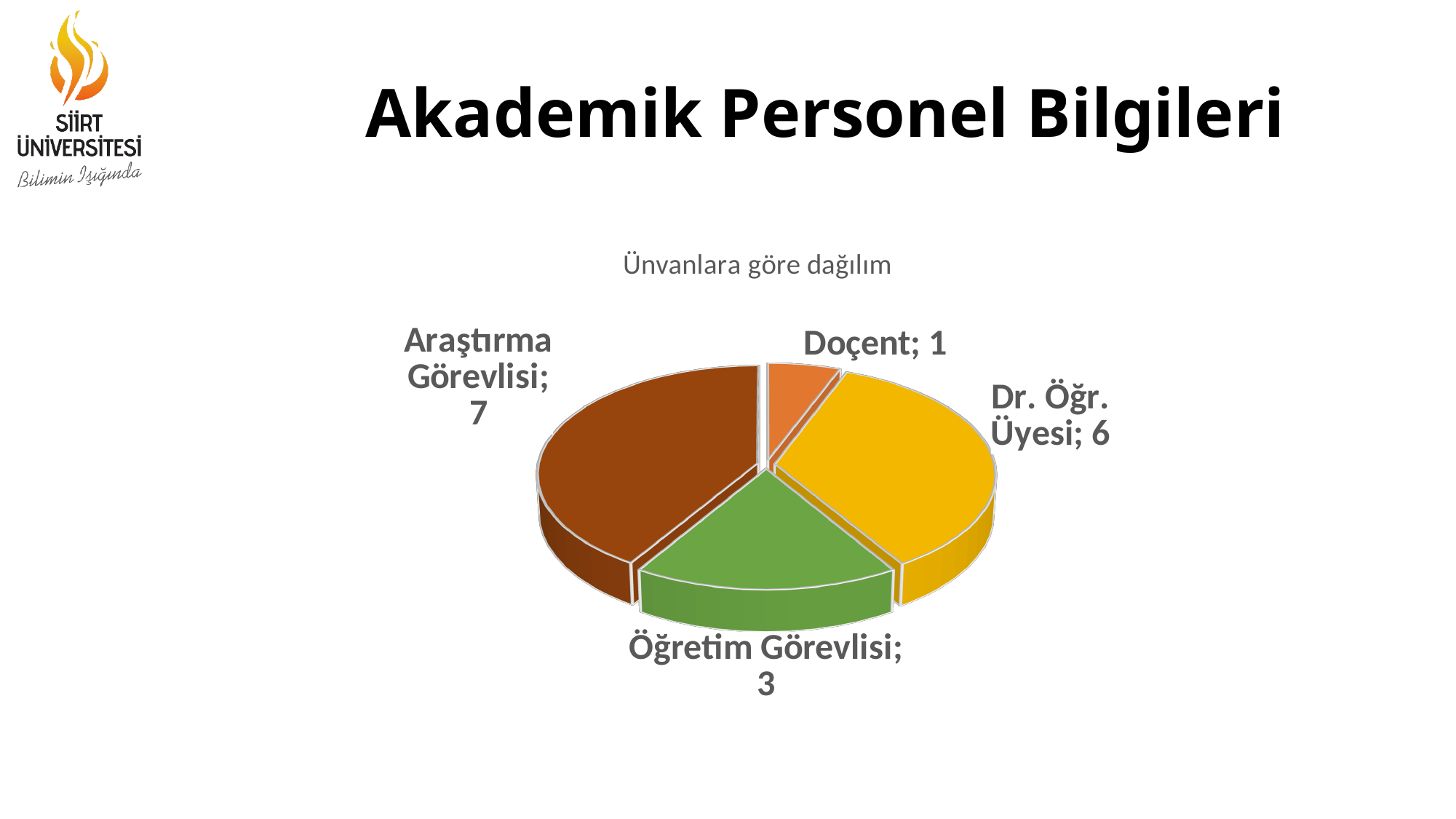
What is the value for Dr. Öğr. Üyesi? 6 What is the title of the chart? Ünvanlara göre dağılım What is the value for Doçent? 1 Which category has the largest slice? Araştırma Görevlisi Which category has the smallest slice? Doçent What is the total of all the slices in the pie chart? 17 How many slices does the pie chart have? 4 Which is larger, the value for Dr. Öğr. Üyesi or the value for Öğretim Görevlisi? Dr. Öğr. Üyesi What is the value for Öğretim Görevlisi? 3 What is the value for Araştırma Görevlisi? 7 What kind of chart is shown on the slide? pie chart What is the difference between the values for Araştırma Görevlisi and Öğretim Görevlisi? 4